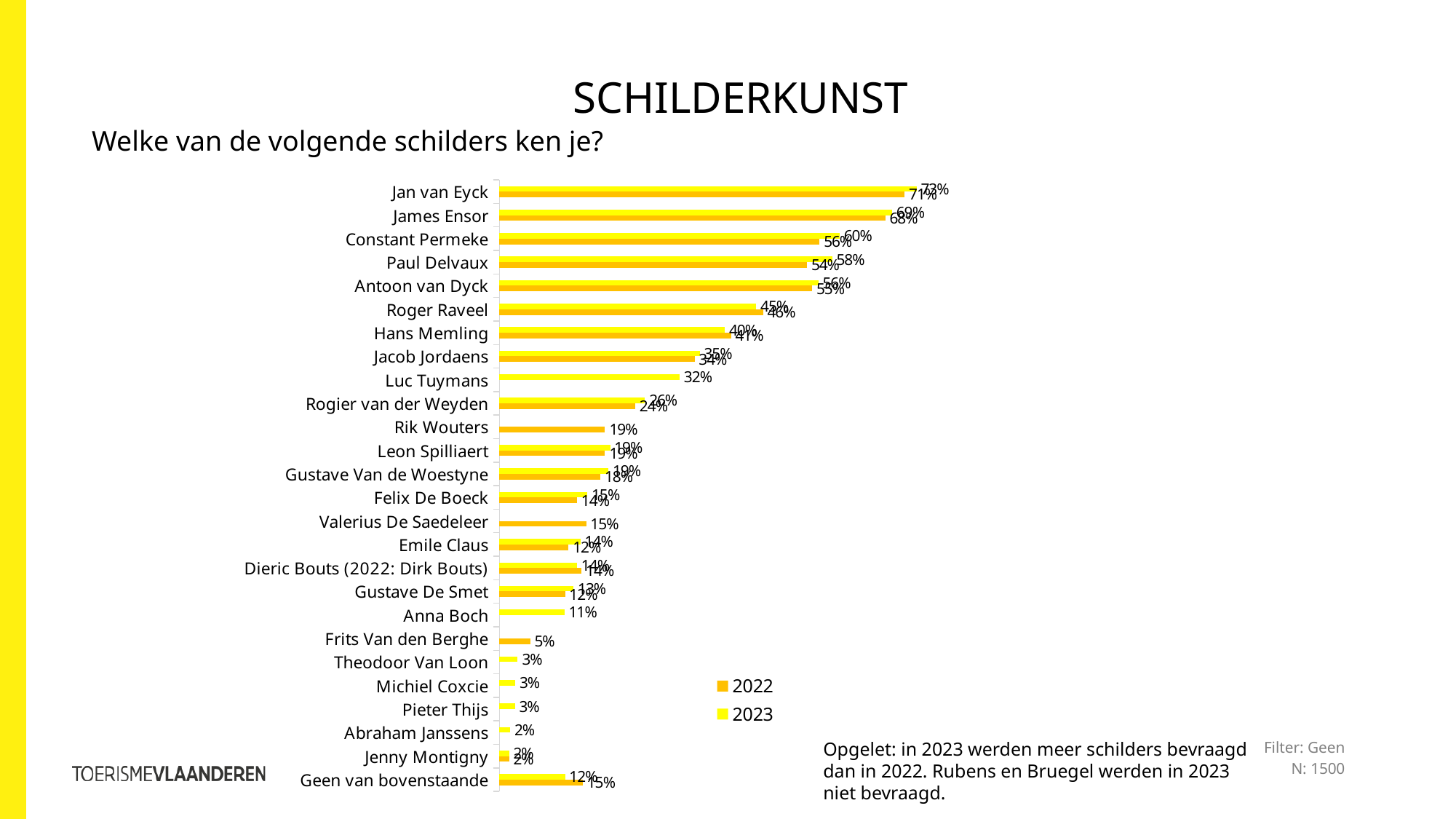
What value is shown for Rik Wouters? 19% Which two series are listed in the legend? 2022 and 2023 What kind of chart is shown on the slide? bar chart What value is shown for Frits Van den Berghe? 5% Which is larger, the value for Luc Tuymans or the value for Anna Boch? Luc Tuymans What value is shown for Luc Tuymans? 32% How many series does the legend list? 2 What value is shown for Anna Boch? 11% How many painter categories (including 'Geen van bovenstaande') are listed on the chart? 26 What is the difference between the value for Luc Tuymans and the value for Anna Boch? 21 percentage points Which painter has the highest value on the chart? Jan van Eyck What value is shown for Abraham Janssens? 2%